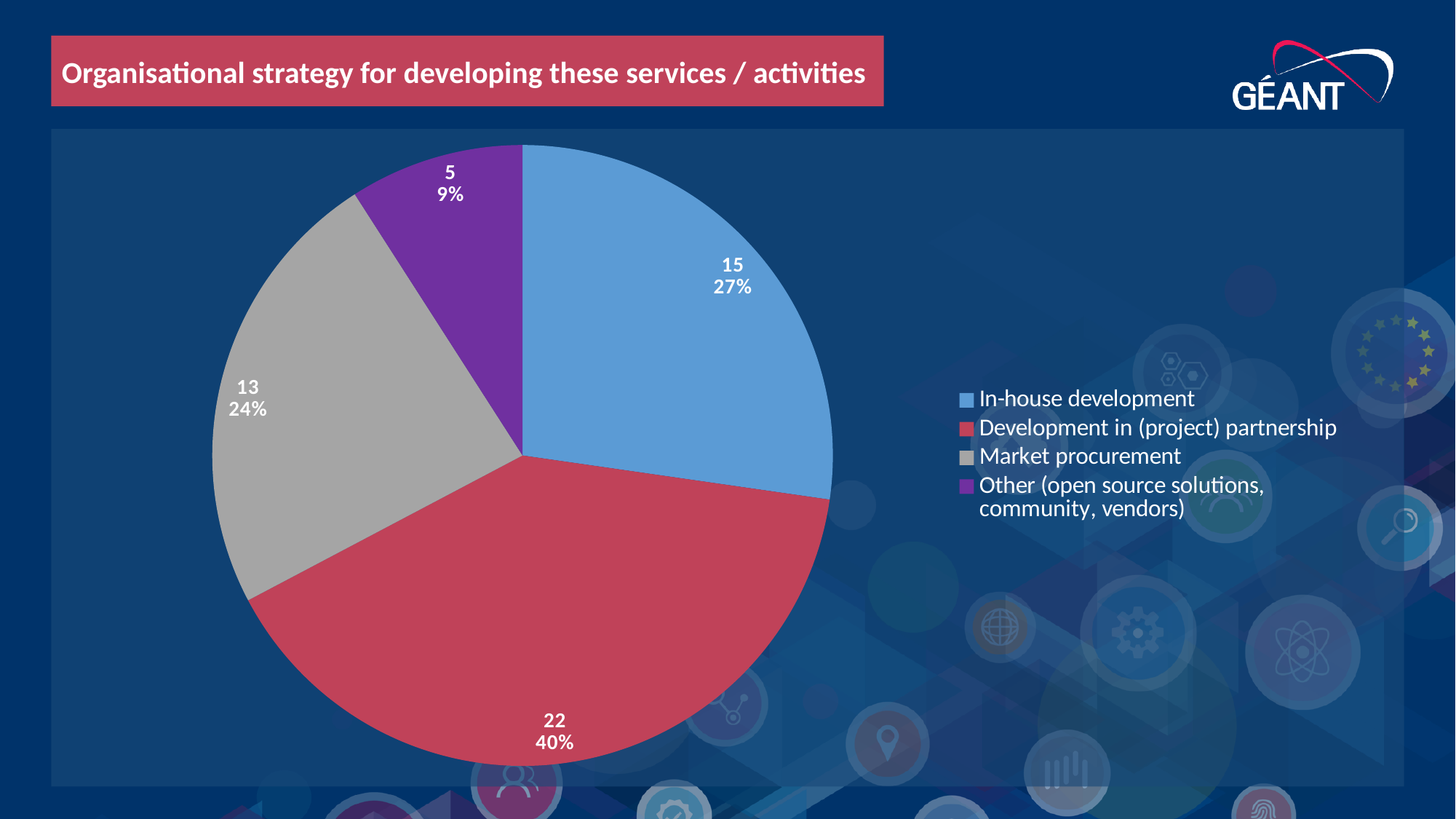
What kind of chart is shown on the slide? Pie chart What percentage share does Other (open source solutions, community, vendors) have? 9% What colour is the Market procurement slice? Grey What percentage share does Development in (project) partnership have? 40% Which category has the smallest slice? Other (open source solutions, community, vendors) Which category has the largest slice? Development in (project) partnership What is the difference in count between Development in (project) partnership and In-house development? 7 Which is larger, In-house development or Market procurement? In-house development What is the count for In-house development? 15 What is the count for Market procurement? 13 How many slices does the pie chart have? 4 What is the total count across all four slices? 55